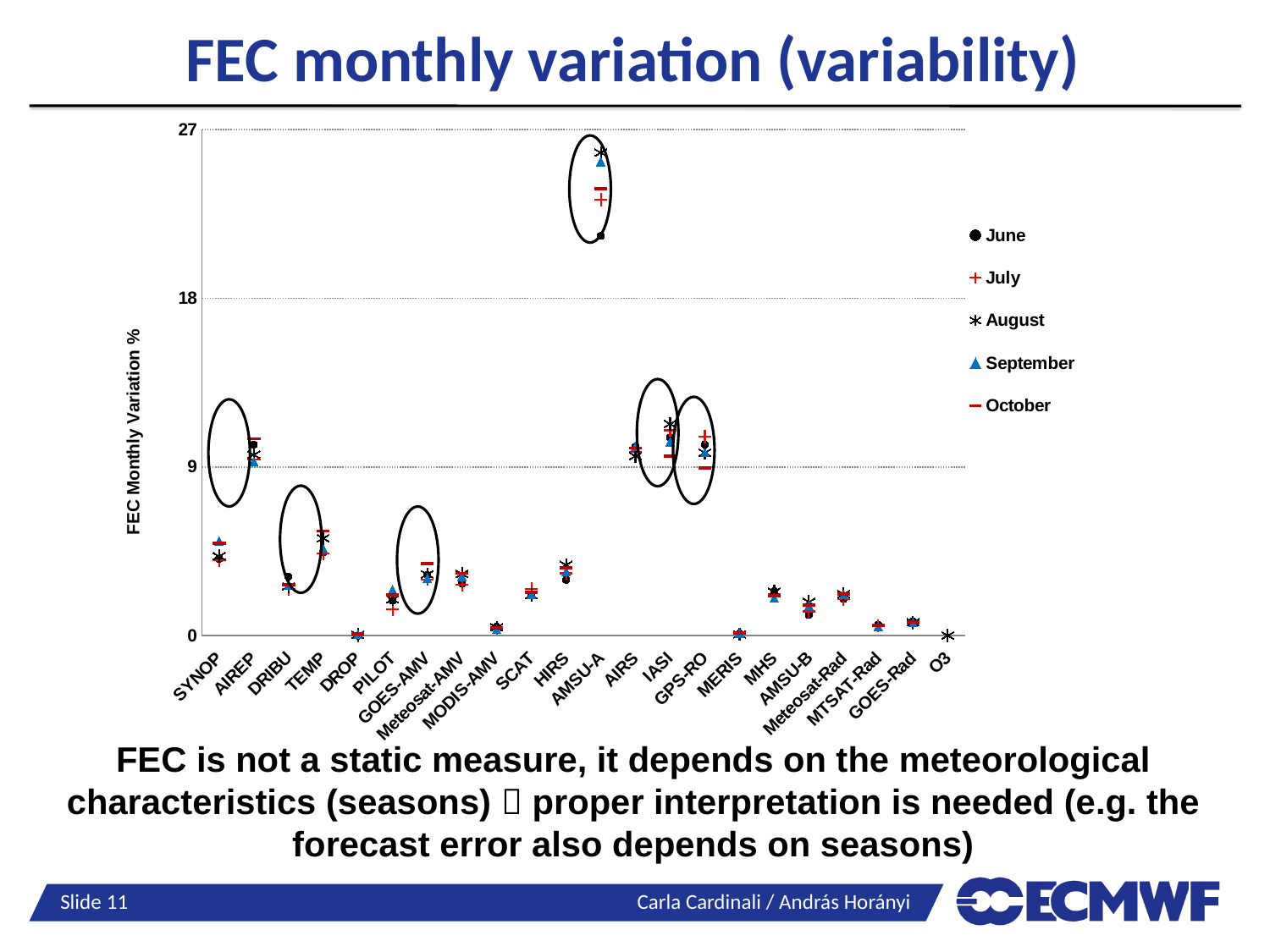
Is the August value for IASI greater or less than 9? greater What kind of chart is shown on the slide? scatter chart Which category has the highest FEC monthly variation values? AMSU-A How many series does the legend list? 5 Is the June value for DRIBU greater or less than 9? less How many observation categories are shown along the x axis? 22 Which has the larger August value, TEMP or PILOT? TEMP What is the label of the y axis? FEC Monthly Variation % Which month is represented by the blue triangle marker in the legend? September Which has the larger June value, AMSU-A or AIRS? AMSU-A Is the August value for SYNOP greater or less than 9? less